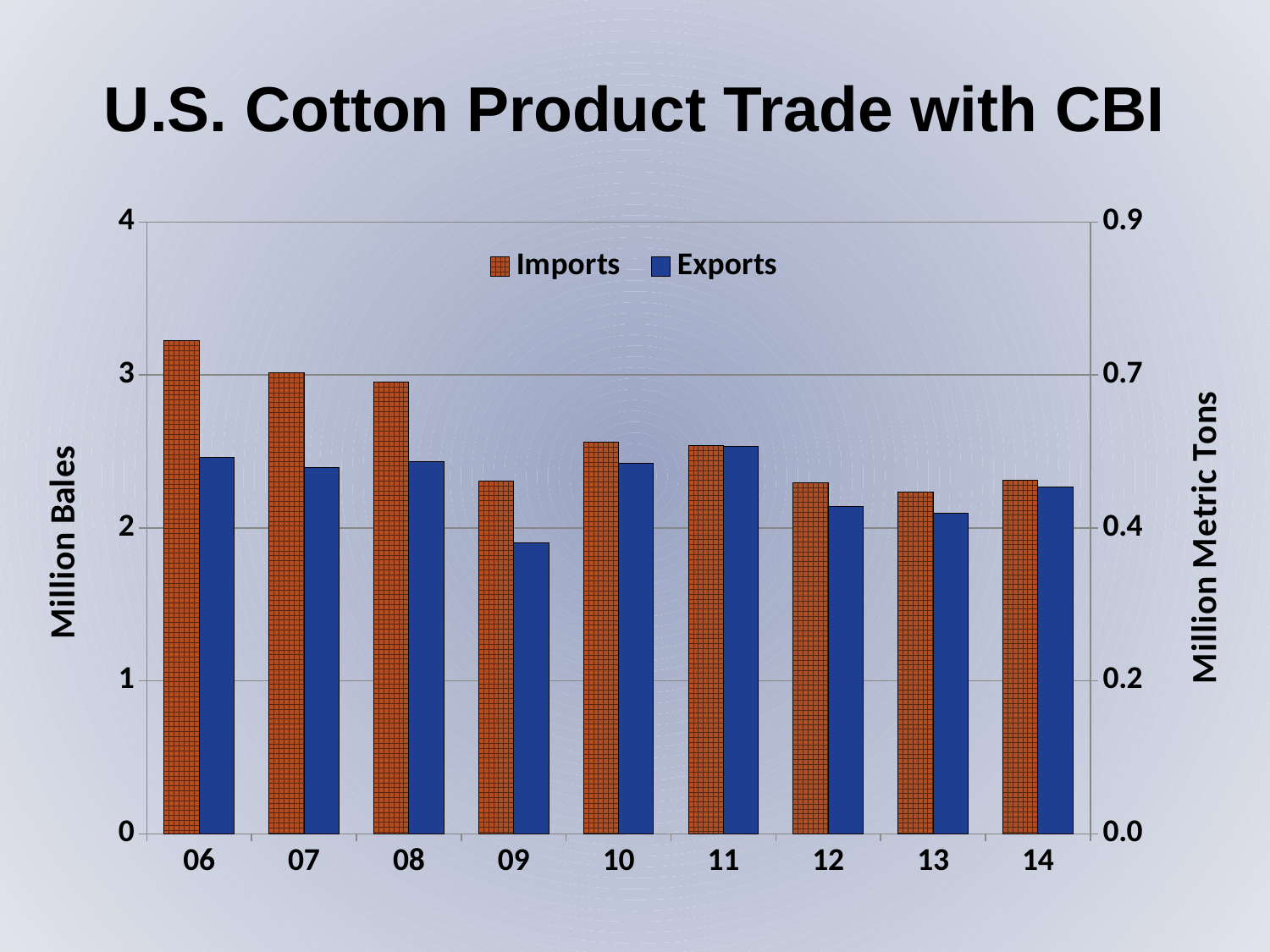
How many series does the legend list? 2 How many years are shown on the x axis? 9 Is the Imports value for 09 greater or less than 2 million bales? greater Which is larger, Imports in 06 or Imports in 09? Imports in 06 Is the Exports value for 09 greater or less than 2 million bales? less What is the label on the left vertical axis? Million Bales Which year has the lowest Exports value? 09 Do Imports generally rise or fall from 06 to 14? Fall In 06, which is larger, Imports or Exports? Imports Which year has the highest Imports value? 06 Is the Imports value for 06 greater or less than 3 million bales? greater What kind of chart is shown on the slide? Bar chart